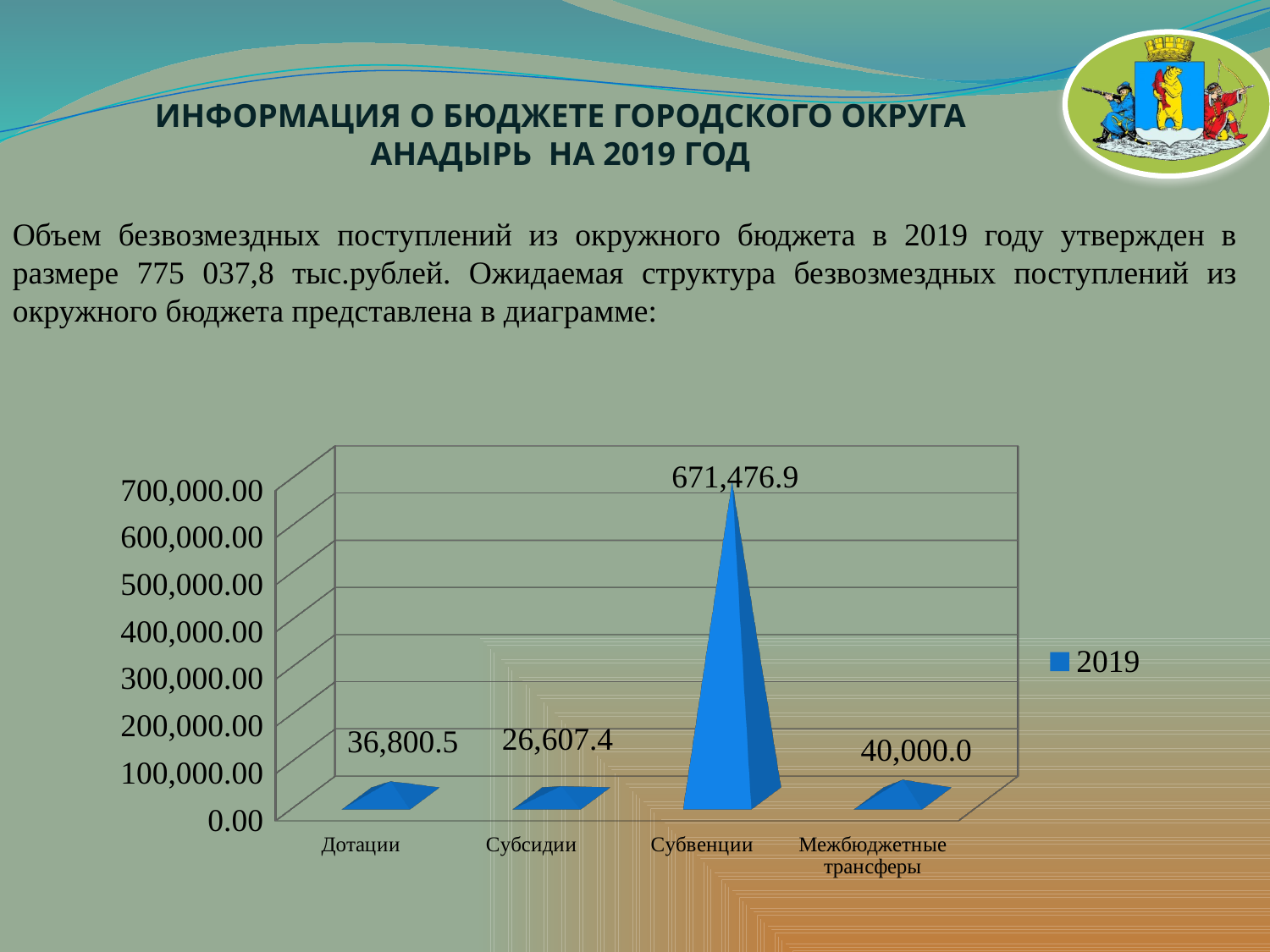
Which category has the highest value? Субвенции How many categories are shown on the x axis? 4 What is the difference between the values for Межбюджетные трансферы and Дотации? 3,199.5 What is the value for Межбюджетные трансферы? 40,000.0 Which category has the lowest value? Субсидии Is the value for Субвенции greater or less than 600,000.00? greater Which is larger, the value for Дотации or the value for Субсидии? Дотации What is the difference between the values for Дотации and Субсидии? 10,193.1 What series does the legend list? 2019 What is the value for Дотации? 36,800.5 What is the value for Субсидии? 26,607.4 What is the value for Субвенции? 671,476.9